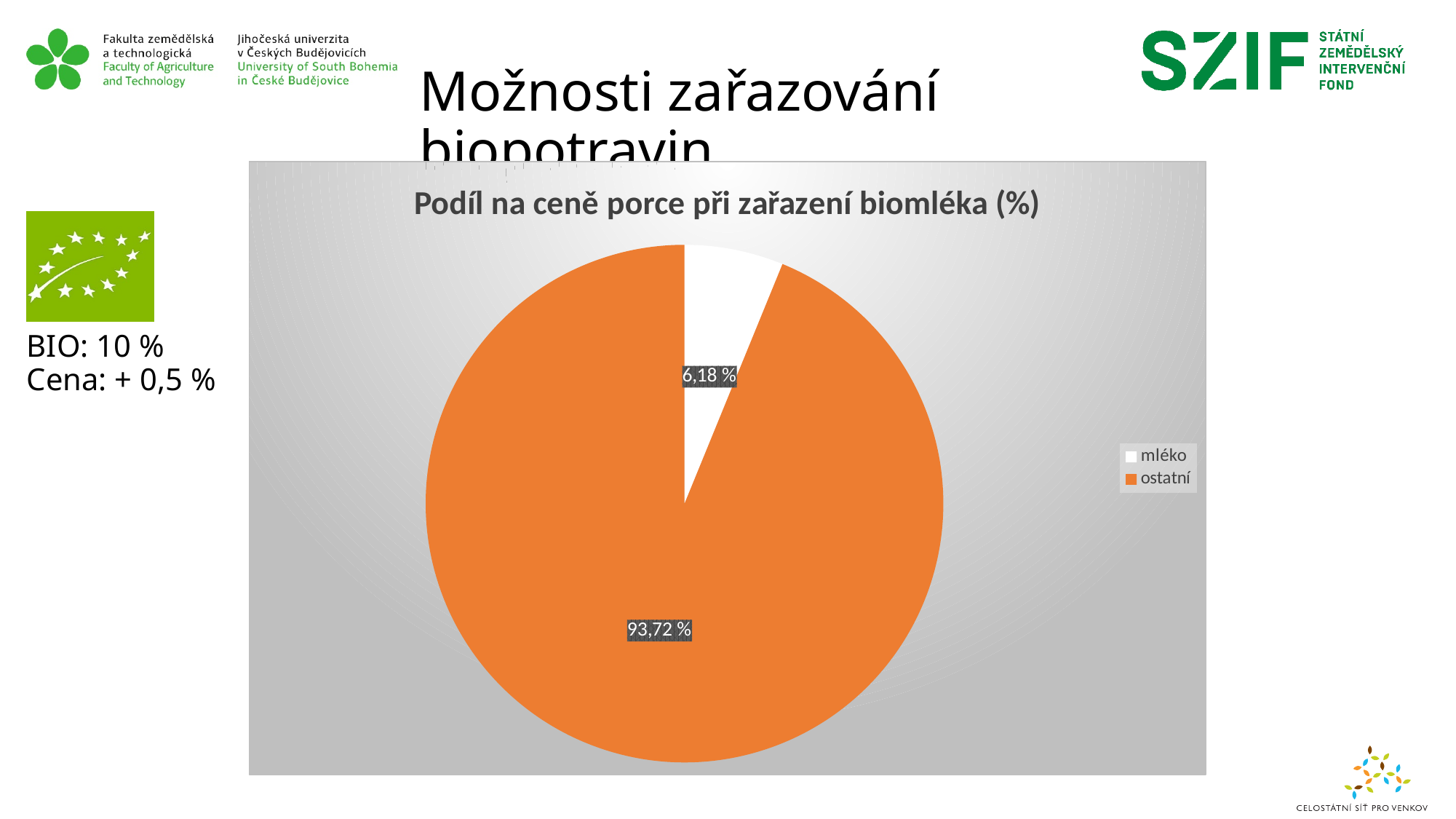
What type of chart is shown on the slide? pie chart What is the value shown for the 'mléko' slice? 6,18 % What is the title of the chart? Podíl na ceně porce při zařazení biomléka (%) What is the difference between the 'ostatní' and 'mléko' values? 87,54 % Which category has the smallest share of the pie? mléko Which category has the largest share of the pie? ostatní Which is larger, the share for 'mléko' or for 'ostatní'? ostatní What is the value shown for the 'ostatní' slice? 93,72 % What colour is the 'ostatní' slice? orange How many entries does the legend list? 2 How many slices does the pie chart have? 2